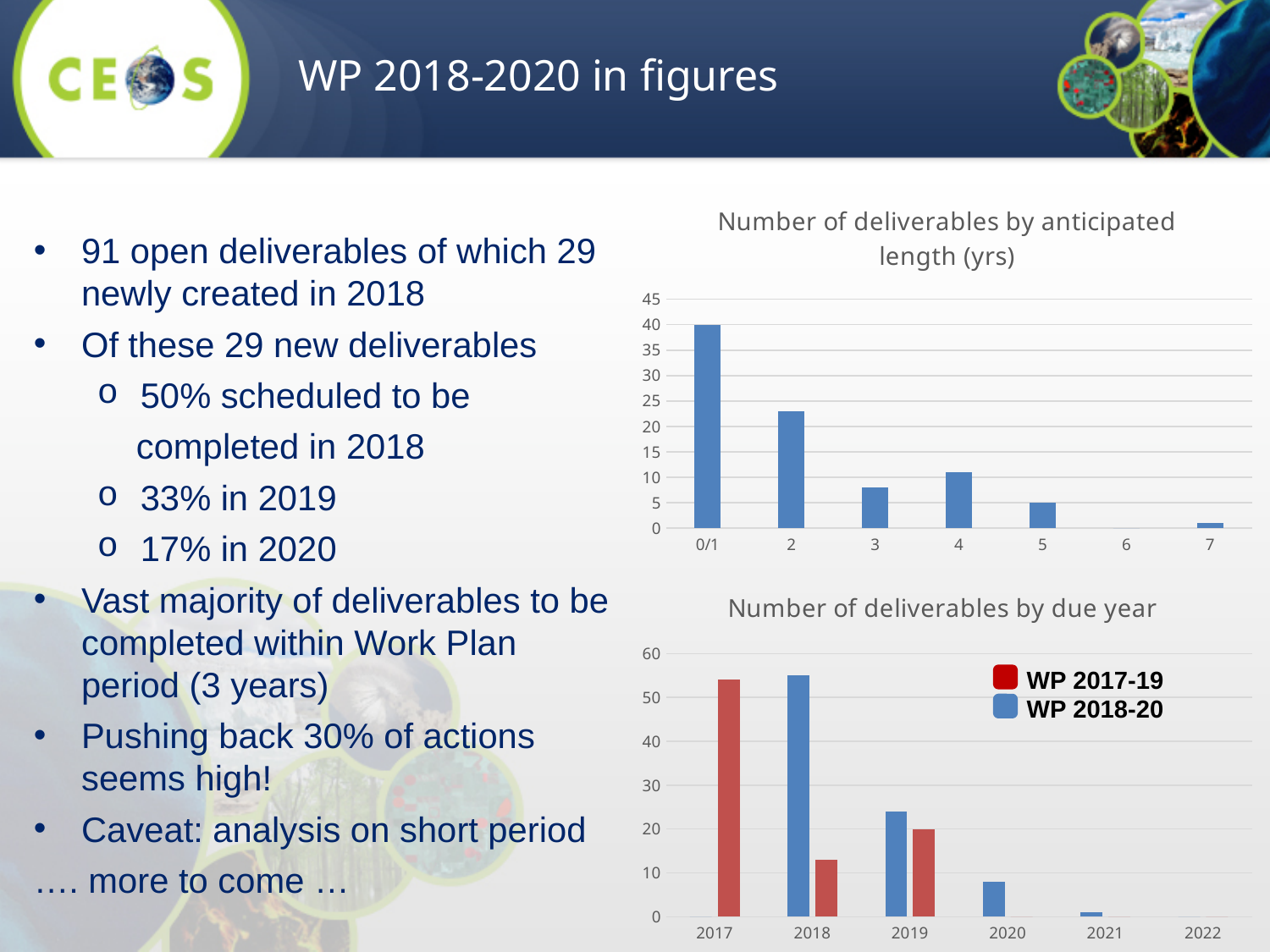
In the 'Number of deliverables by anticipated length (yrs)' chart, how many length categories are shown on the x axis? 7 In the 'Number of deliverables by anticipated length (yrs)' chart, is the value for category 2 greater or less than 20? greater In the 'Number of deliverables by due year' chart, which year has the highest value for WP 2018-20? 2018 In the 'Number of deliverables by due year' chart, for 2019, which series has the larger value, WP 2017-19 or WP 2018-20? WP 2018-20 In the 'Number of deliverables by anticipated length (yrs)' chart, which has more deliverables, category 2 or category 4? 2 How many series does the legend of the 'Number of deliverables by due year' chart list? 2 In the 'Number of deliverables by anticipated length (yrs)' chart, what is the number of deliverables for the 0/1 category? 40 In the 'Number of deliverables by due year' chart, is the WP 2017-19 value for 2017 greater or less than 50? greater What are the two series named in the legend of the 'Number of deliverables by due year' chart? WP 2017-19 and WP 2018-20 What kind of chart is the 'Number of deliverables by anticipated length (yrs)' chart? bar chart In the 'Number of deliverables by anticipated length (yrs)' chart, is the value for category 3 greater or less than 10? less In the 'Number of deliverables by anticipated length (yrs)' chart, which length category has the highest number of deliverables? 0/1